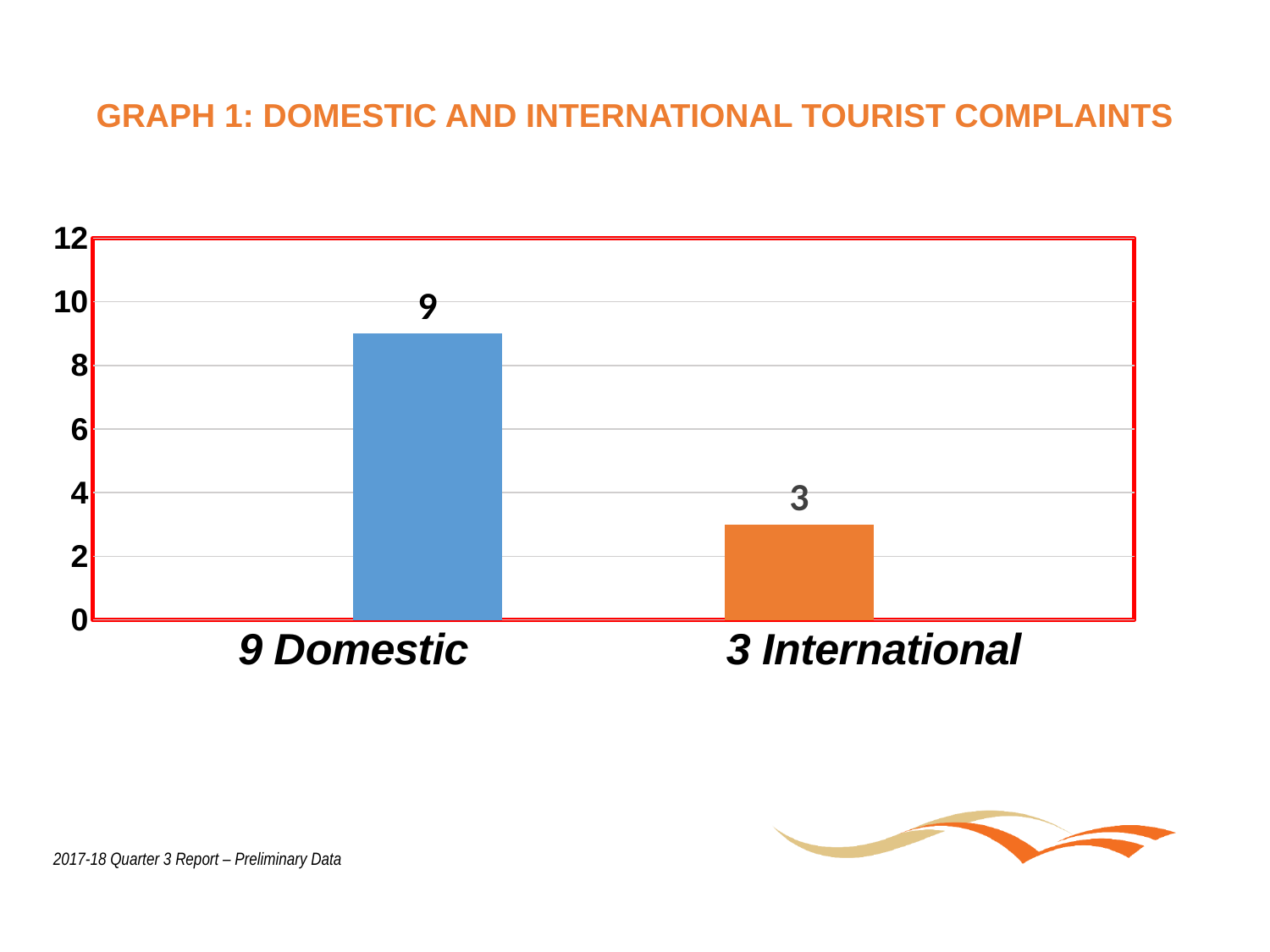
Is the value for International greater or less than 4? less How many categories are shown in the chart? 2 Is the value for Domestic greater or less than 8? greater What is the value for International tourist complaints? 3 What colour is the International bar? Orange Which is larger, the Domestic value or the International value? Domestic Which category has the lowest value? International Which category has the highest value? Domestic What kind of chart is shown on the slide? Bar chart What is the difference between the Domestic and International values? 6 What is the value for Domestic tourist complaints? 9 What is the title of the chart? GRAPH 1: DOMESTIC AND INTERNATIONAL TOURIST COMPLAINTS